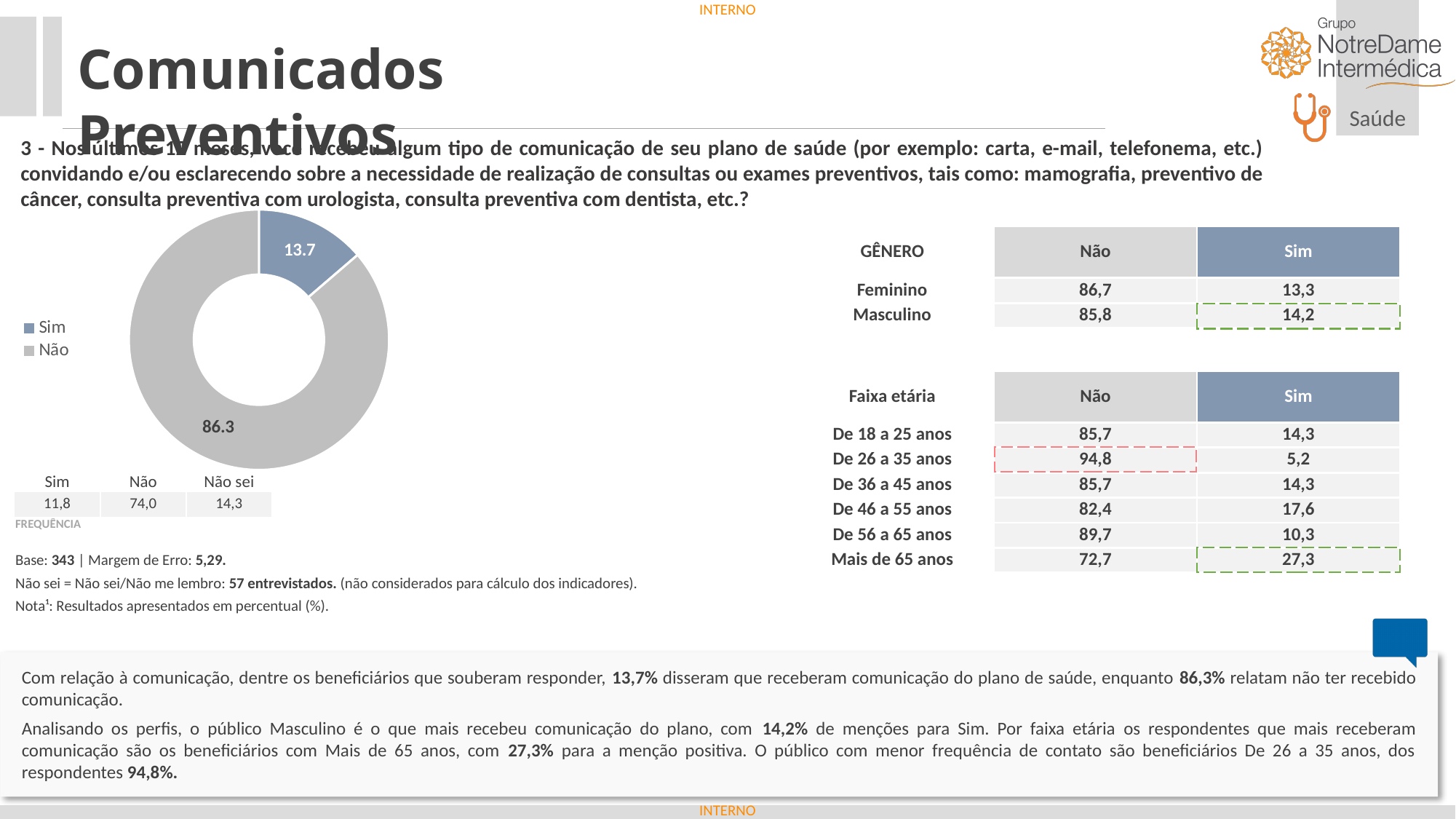
How many entries does the legend of the donut chart list? 2 What are the two legend entries of the donut chart? Sim and Não In the donut chart, what is the value shown for Não? 86.3 What share of the donut chart does the Sim slice represent? 13.7% In the donut chart, which is larger, the value for Sim or the value for Não? Não What is the difference between the Não and Sim values in the donut chart? 72.6 What type of chart is shown on the left of the slide? Donut (pie) chart How many slices does the donut chart have? 2 In the donut chart, what is the value shown for Sim? 13.7 Which category has the largest slice in the donut chart? Não What colour is the Sim slice in the donut chart? Blue Which category has the smallest slice in the donut chart? Sim